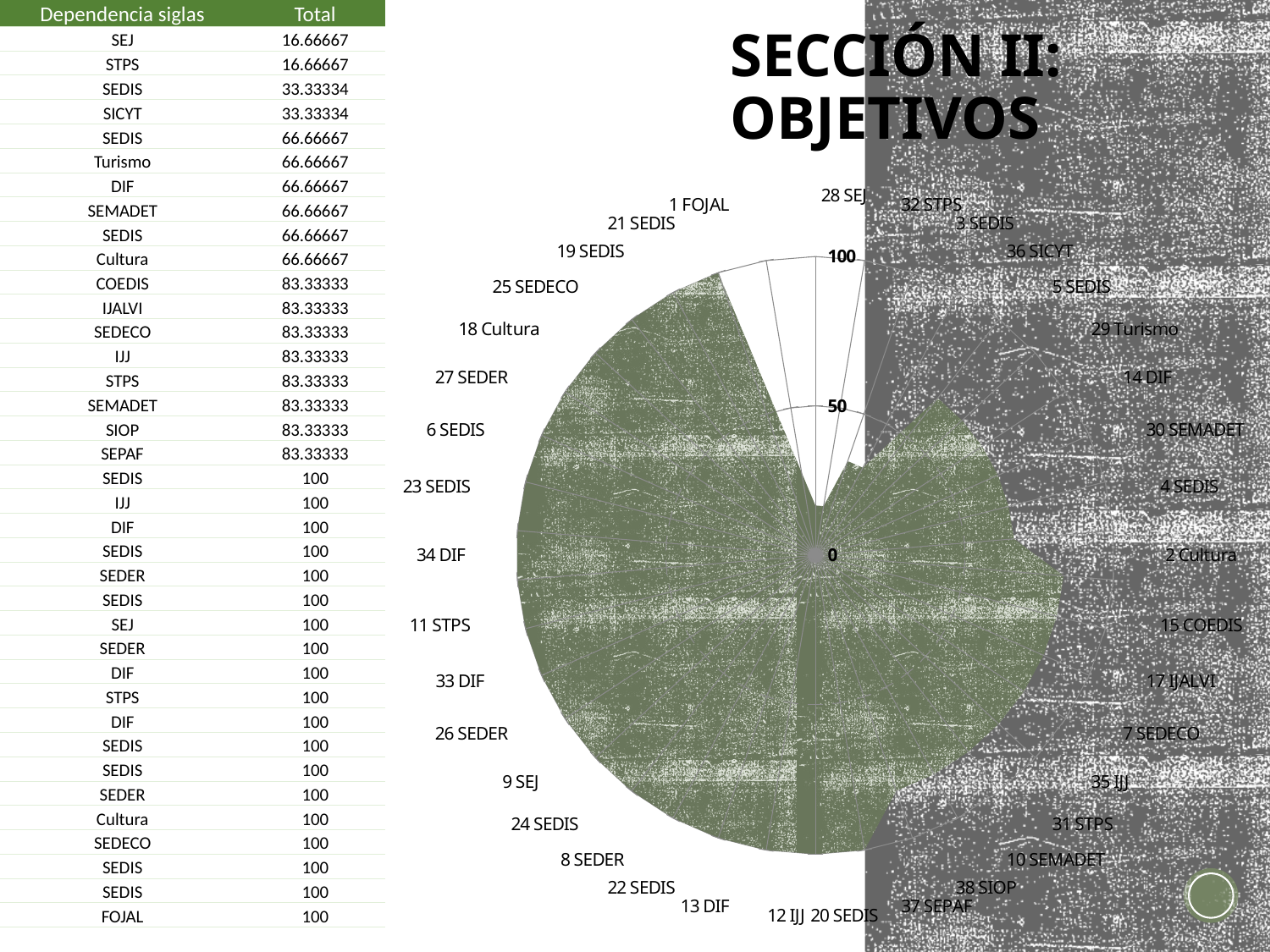
According to the table on the slide, what is the Total for COEDIS? 83.33333 Is the value for 28 SEJ on the radar chart greater or less than 50? less Is the value for 32 STPS on the radar chart greater or less than 50? less Is the value for 2 Cultura on the radar chart greater or less than 50? greater What is the title shown on the slide? SECCIÓN II: OBJETIVOS What kind of chart is shown on the slide? radar chart According to the table on the slide, what is the Total for SICYT? 33.33334 According to the table on the slide, which has the larger Total, SICYT or Turismo? Turismo What is the highest value marked on the radar chart's axis? 100 According to the table on the slide, what is the Total for Turismo? 66.66667